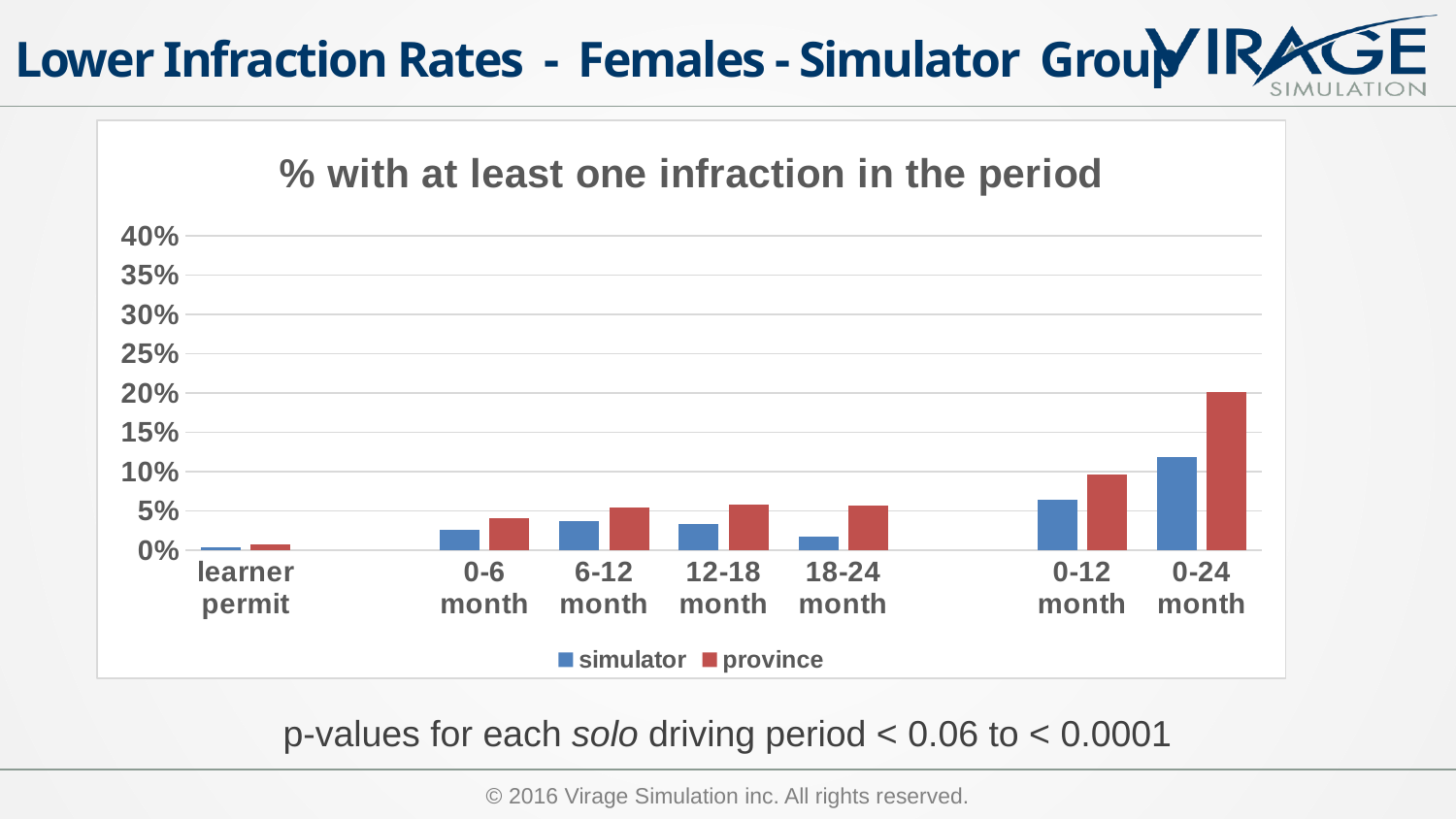
How many series does the legend list? 2 Is the simulator value for 18-24 month greater or less than 5%? less Which category has the lowest simulator value? learner permit How many categories are shown on the x axis? 7 What is the title of the chart? % with at least one infraction in the period Is the simulator value for 0-24 month greater or less than 10%? greater For the 18-24 month period, which series has the larger value, simulator or province? province Is the province value for 0-24 month greater or less than 15%? greater What kind of chart is shown on the slide? bar chart For the 0-24 month period, which series has the larger value, simulator or province? province Which colour represents the province series in the legend? red Which category has the highest province value? 0-24 month